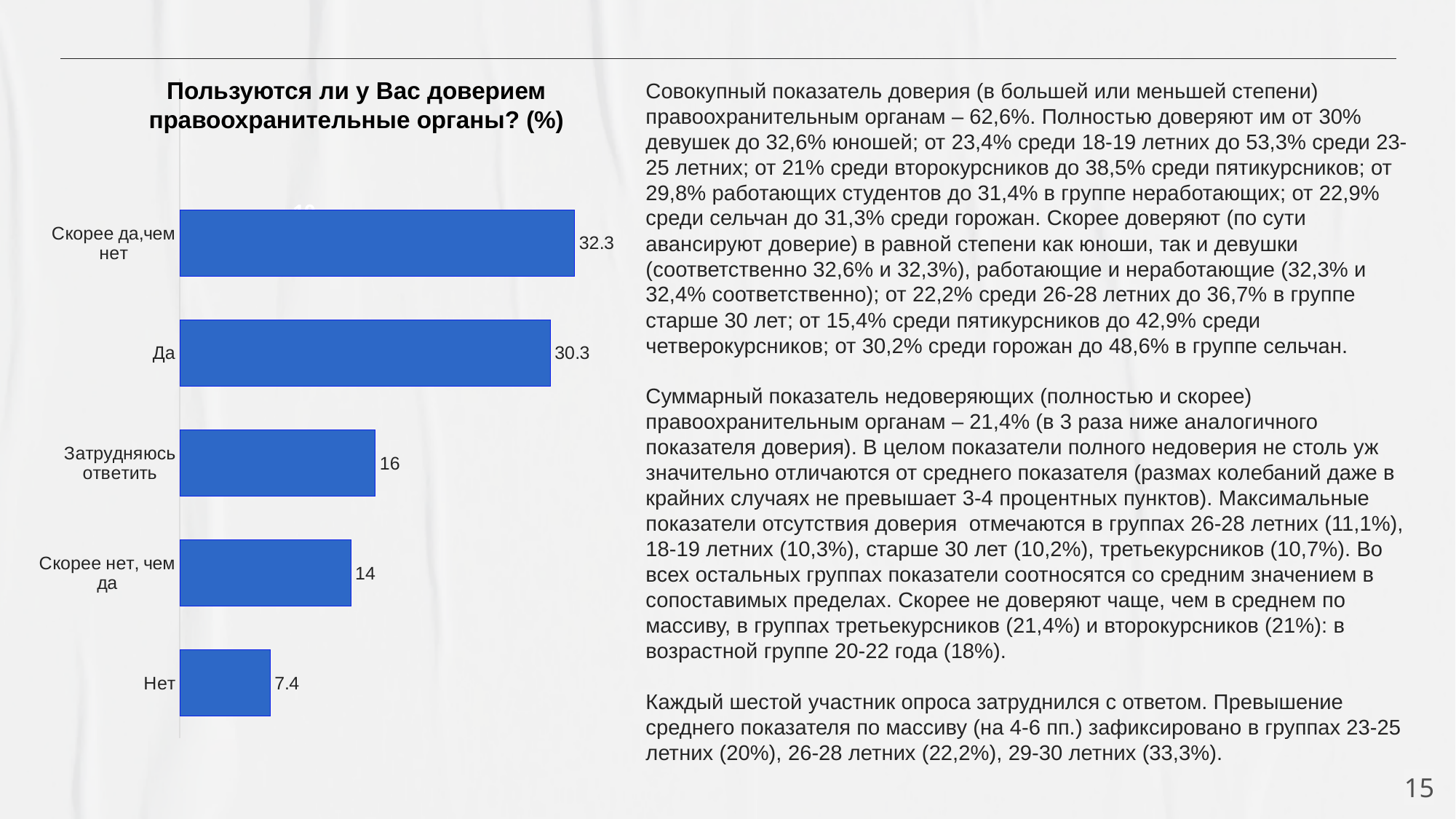
What is the value for "Затрудняюсь ответить"? 16 What is the difference between the values for "Скорее да, чем нет" and "Да"? 2 Which is larger, the value for "Затрудняюсь ответить" or the value for "Скорее нет, чем да"? Затрудняюсь ответить Which category has the highest value? Скорее да, чем нет What is the value for "Скорее да, чем нет"? 32.3 Which category has the lowest value? Нет What is the value for "Да"? 30.3 What is the value for "Скорее нет, чем да"? 14 How many categories are shown in the chart? 5 What type of chart is shown on the slide? bar chart What is the value for "Нет"? 7.4 What is the difference between the values for "Затрудняюсь ответить" and "Нет"? 8.6